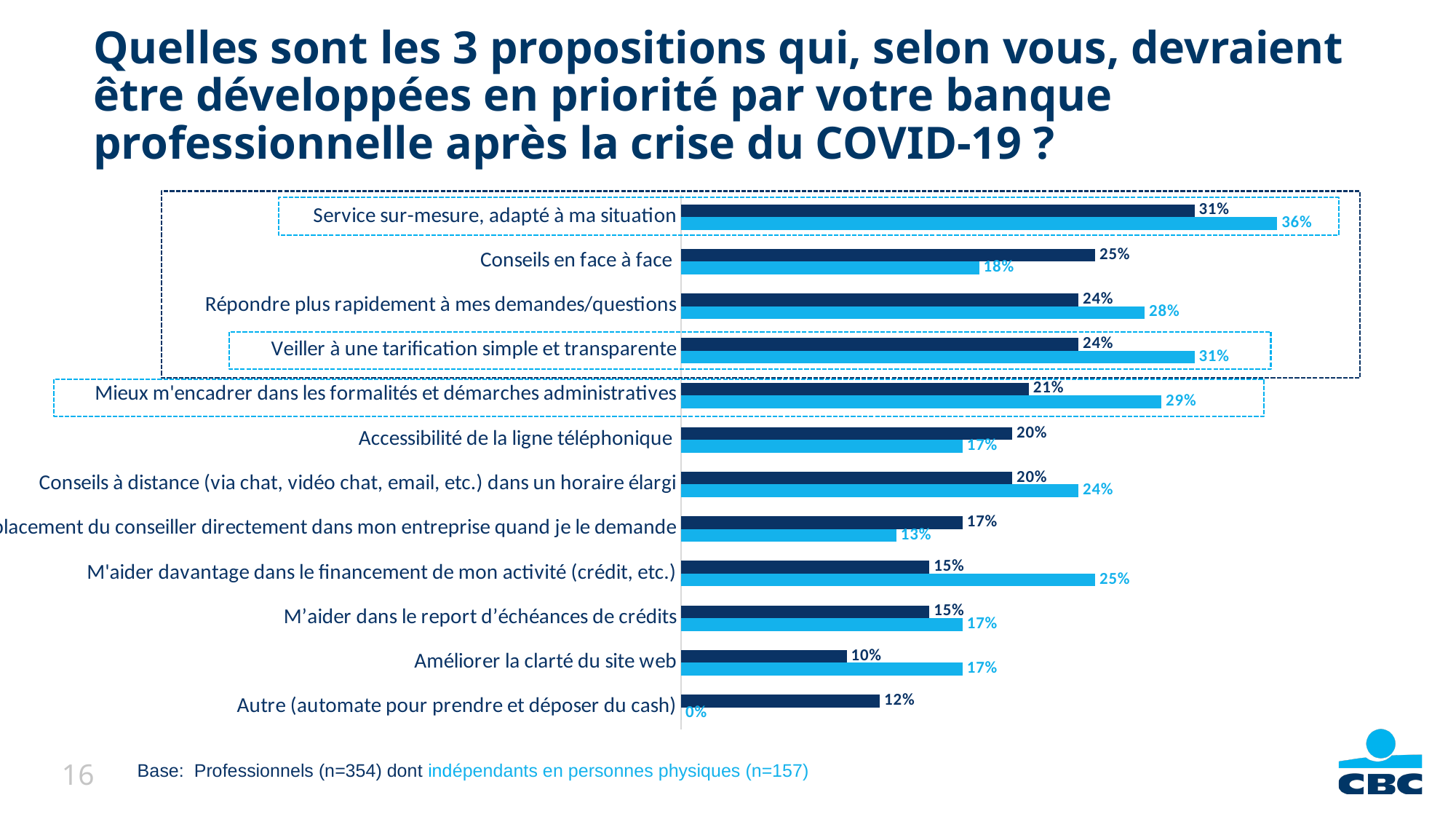
What is the light blue value for "Service sur-mesure, adapté à ma situation"? 36% What is the light blue value for "Conseils en face à face"? 18% How many categories (propositions) are listed in the chart? 12 What is the dark blue value for "Améliorer la clarté du site web"? 10% Which category has the lowest dark blue value? Améliorer la clarté du site web Which category has the highest light blue value? Service sur-mesure, adapté à ma situation What type of chart is shown on the slide? bar chart What is the dark blue value for "Service sur-mesure, adapté à ma situation"? 31% What is the difference between the light blue and dark blue values for "M'aider davantage dans le financement de mon activité (crédit, etc.)"? 10% According to the base note, how many professionals (n) were surveyed in total? 354 What is the light blue value for "Autre (automate pour prendre et déposer du cash)"? 0% For "Conseils en face à face", which is larger: the dark blue value or the light blue value? dark blue